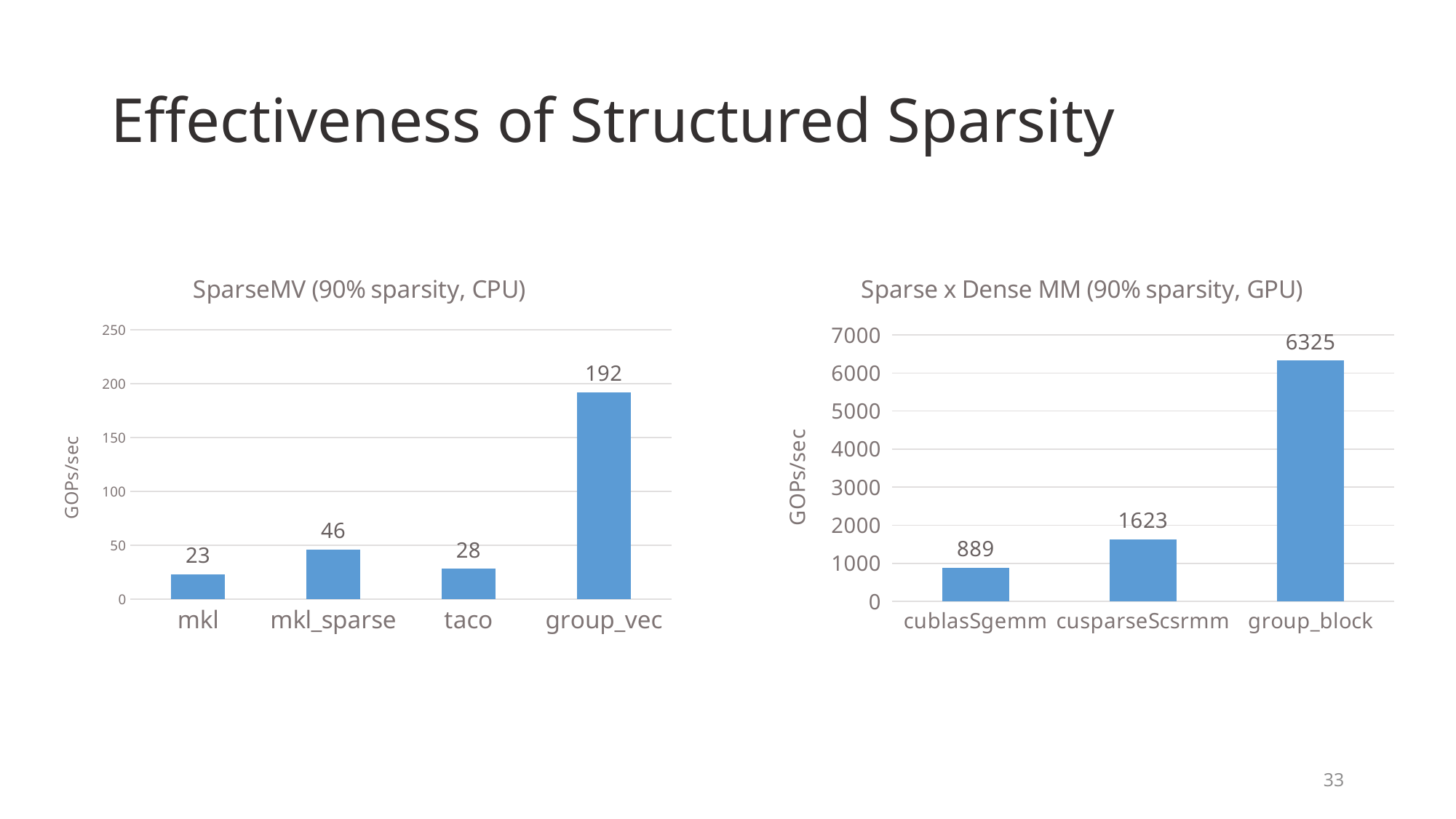
In the Sparse x Dense MM (90% sparsity, GPU) chart, is the value for group_block greater or less than 6000? greater In the Sparse x Dense MM (90% sparsity, GPU) chart, what is the value for cusparseScsrmm? 1623 In the Sparse x Dense MM (90% sparsity, GPU) chart, which category has the highest value? group_block In the Sparse x Dense MM (90% sparsity, GPU) chart, what is the difference between group_block and cublasSgemm? 5436 What kind of chart is the SparseMV (90% sparsity, CPU) chart? bar chart In the SparseMV (90% sparsity, CPU) chart, what is the value for group_vec? 192 In the SparseMV (90% sparsity, CPU) chart, how many categories are shown? 4 In the Sparse x Dense MM (90% sparsity, GPU) chart, which is larger, cublasSgemm or cusparseScsrmm? cusparseScsrmm In the SparseMV (90% sparsity, CPU) chart, what is the value for mkl_sparse? 46 What is the y-axis label of the Sparse x Dense MM (90% sparsity, GPU) chart? GOPs/sec In the SparseMV (90% sparsity, CPU) chart, what is the difference between group_vec and taco? 164 In the SparseMV (90% sparsity, CPU) chart, which category has the lowest value? mkl